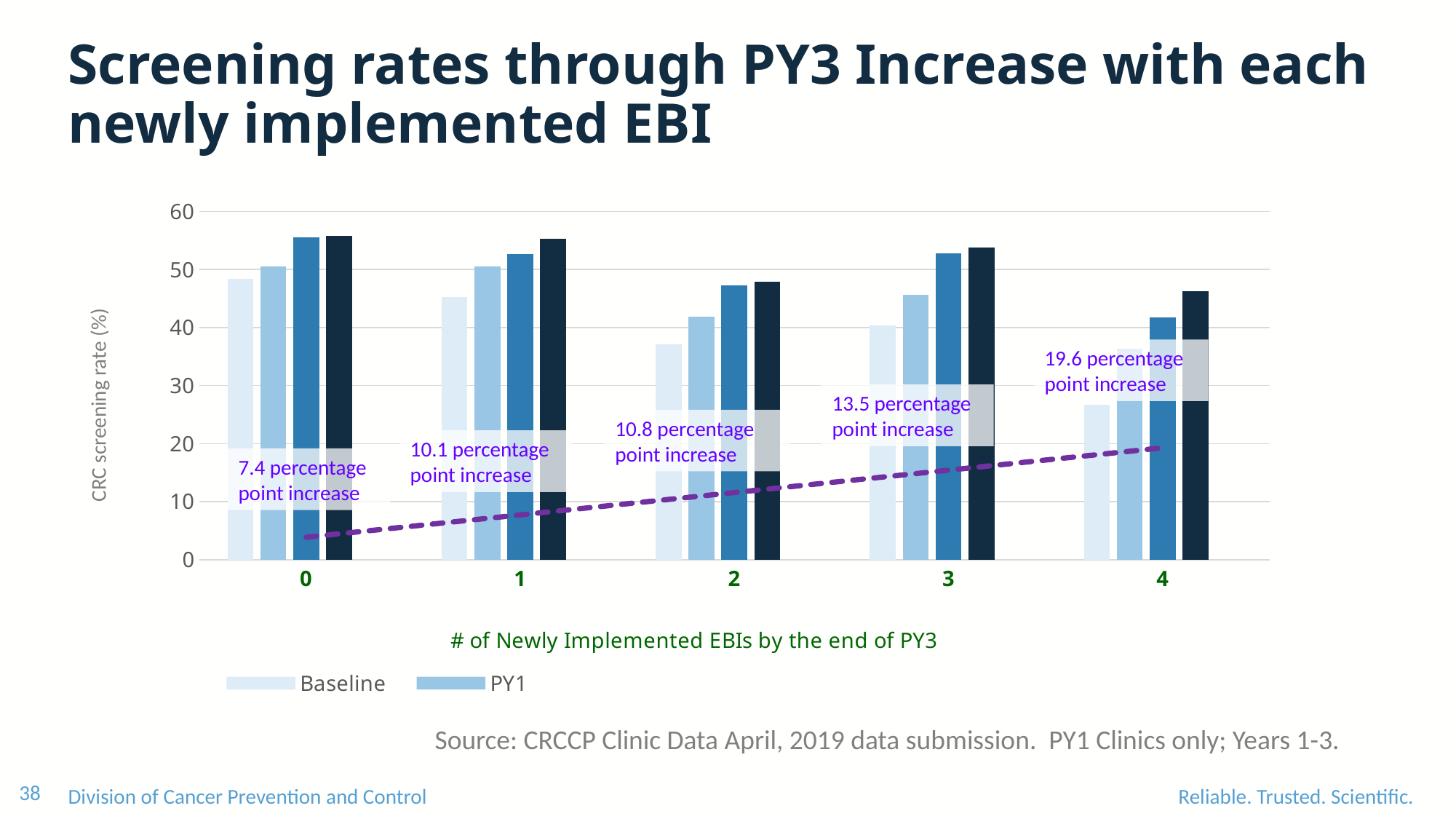
Is the Baseline screening rate for clinics with 0 newly implemented EBIs greater or less than 40? greater What kind of chart is shown on the slide? Bar chart How many categories (numbers of newly implemented EBIs) are shown on the x axis? 5 Does the annotated percentage point increase rise or fall as the number of newly implemented EBIs increases? Rise How many series does the legend list? 2 Which number of newly implemented EBIs has the smallest annotated percentage point increase? 0 Which has the higher Baseline screening rate: clinics with 0 newly implemented EBIs or clinics with 4? 0 Which number of newly implemented EBIs has the largest annotated percentage point increase? 4 What percentage point increase is annotated for clinics with 0 newly implemented EBIs? 7.4 percentage point increase What is the difference between the annotated percentage point increase for 4 EBIs and for 0 EBIs? 12.2 percentage points What percentage point increase is annotated for clinics with 3 newly implemented EBIs? 13.5 percentage point increase Is the Baseline screening rate for clinics with 4 newly implemented EBIs greater or less than 30? less